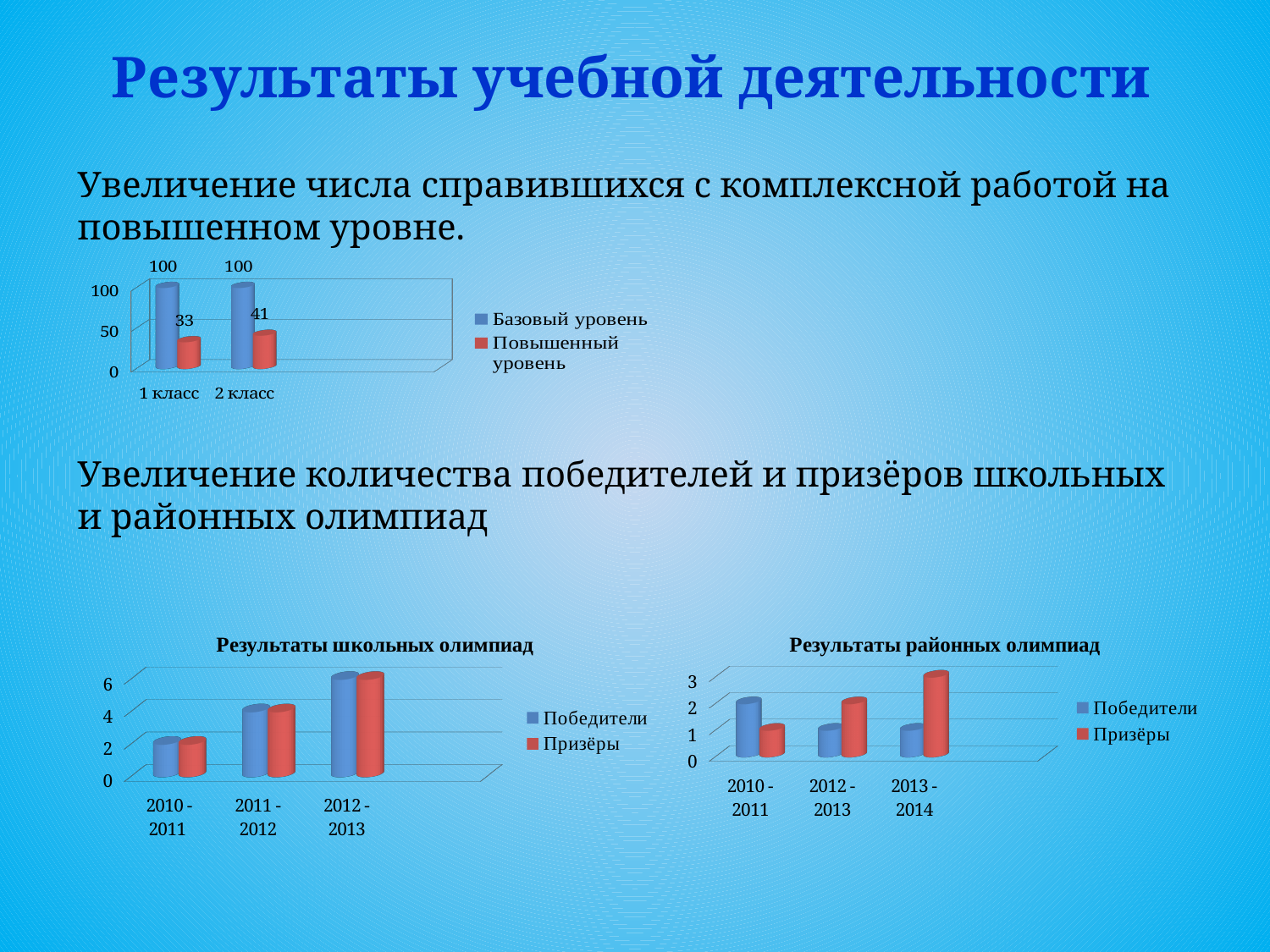
In the top chart about the complex work, what is the difference between Базовый уровень and Повышенный уровень for 2 класс? 59 In the top chart about the complex work, what is the value for Повышенный уровень in 2 класс? 41 In the chart titled Результаты школьных олимпиад, how many categories are shown on the x axis? 3 In the chart titled Результаты районных олимпиад, which is larger in 2010-2011, Победители or Призёры? Победители What kind of chart is Результаты районных олимпиад? bar chart In the chart titled Результаты школьных олимпиад, is the value for Призёры in 2012-2013 greater or less than 4? greater In the top chart about the complex work, what is the value for Базовый уровень in 1 класс? 100 In the top chart about the complex work, how many series does the legend list? 2 In the top chart about the complex work, what is the value for Повышенный уровень in 1 класс? 33 In the top chart about the complex work, which class has the higher value for Повышенный уровень, 1 класс or 2 класс? 2 класс In the chart titled Результаты районных олимпиад, which category has the highest value for Призёры? 2013-2014 In the chart titled Результаты школьных олимпиад, do the values for Победители rise or fall from 2010-2011 to 2012-2013? rise